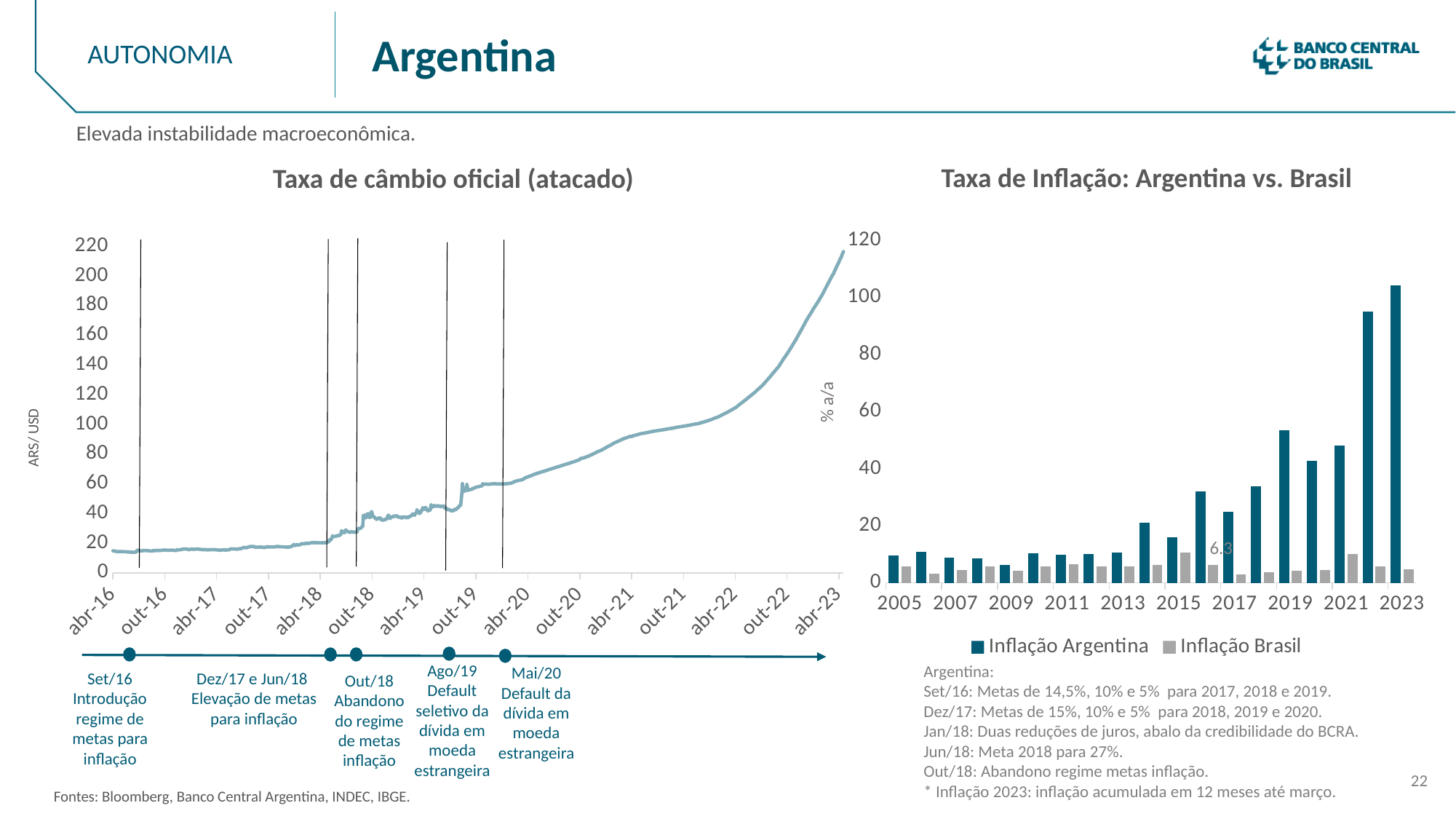
In the 'Taxa de câmbio oficial (atacado)' chart, is the value at abr-23 greater or less than 200? greater In the 'Taxa de Inflação: Argentina vs. Brasil' chart, is the Inflação Argentina value for 2019 greater or less than 40? greater In the 'Taxa de câmbio oficial (atacado)' chart, does the exchange rate generally rise or fall from abr-16 to abr-23? rise What kind of chart is the 'Taxa de Inflação: Argentina vs. Brasil' chart? bar chart In the 'Taxa de Inflação: Argentina vs. Brasil' chart, which is larger in 2019: Inflação Argentina or Inflação Brasil? Inflação Argentina In the 'Taxa de Inflação: Argentina vs. Brasil' chart, is the Inflação Argentina value for 2022 greater or less than 100? less In the 'Taxa de Inflação: Argentina vs. Brasil' chart, how many series does the legend list? 2 What is the y-axis unit label on the 'Taxa de câmbio oficial (atacado)' chart? ARS/ USD What kind of chart is the 'Taxa de câmbio oficial (atacado)' chart? line chart In the 'Taxa de Inflação: Argentina vs. Brasil' chart, which year has the highest Inflação Argentina value? 2023